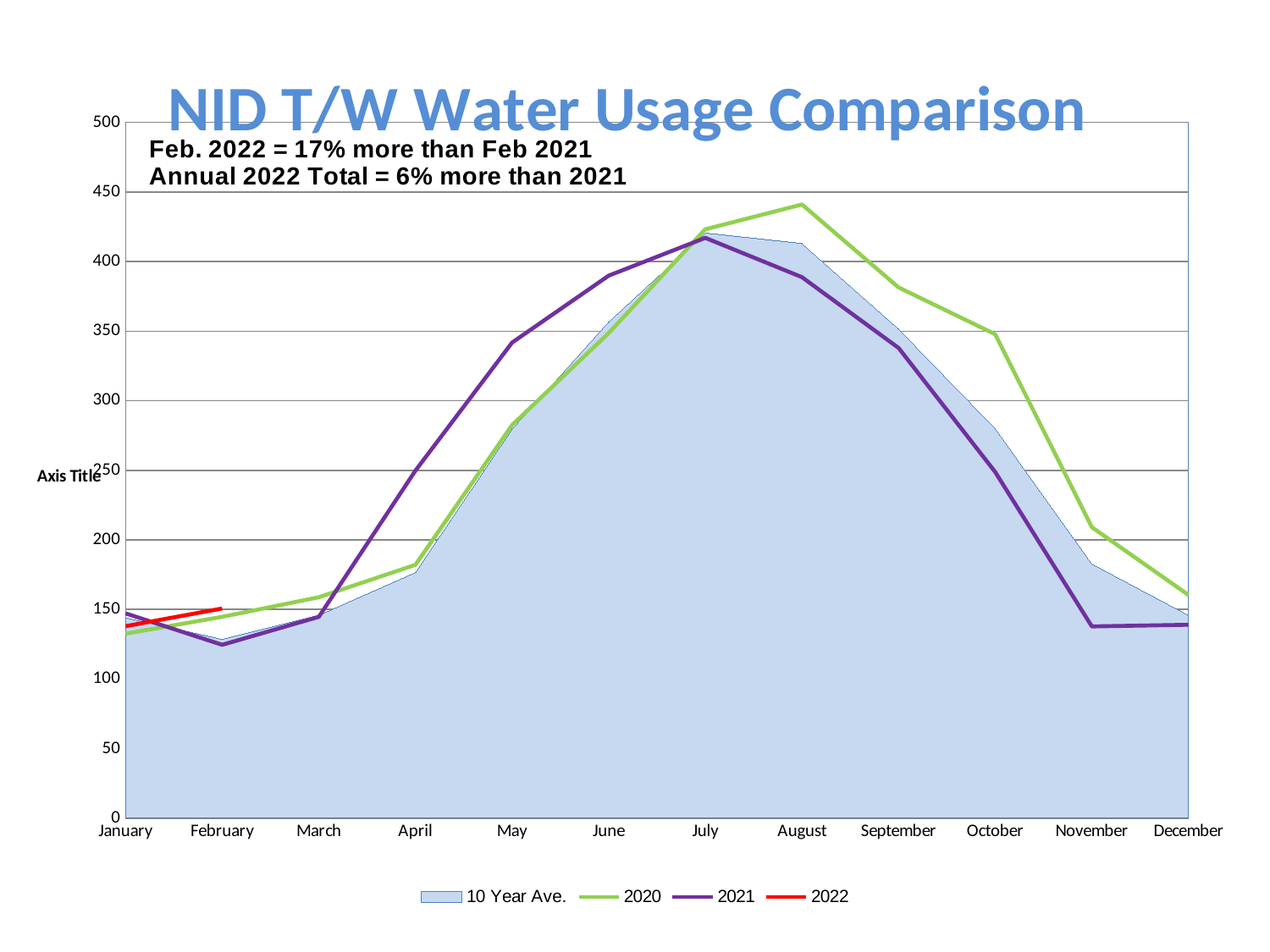
Is the 2020 value for August greater or less than 400? greater In which month does the 2020 series reach its highest value? August Is the 2020 value for December greater or less than 200? less In April, which series has the higher value, 2020 or 2021? 2021 How many series does the legend list? 4 In which month does the 2021 series reach its highest value? July How many months are shown along the x axis? 12 In which month is the 2021 series at its lowest value? February Does the 2021 series rise or fall from July to November? fall Is the 2021 value for May greater or less than 300? greater What is the title of the chart? NID T/W Water Usage Comparison In October, which series has the higher value, 2020 or 2021? 2020